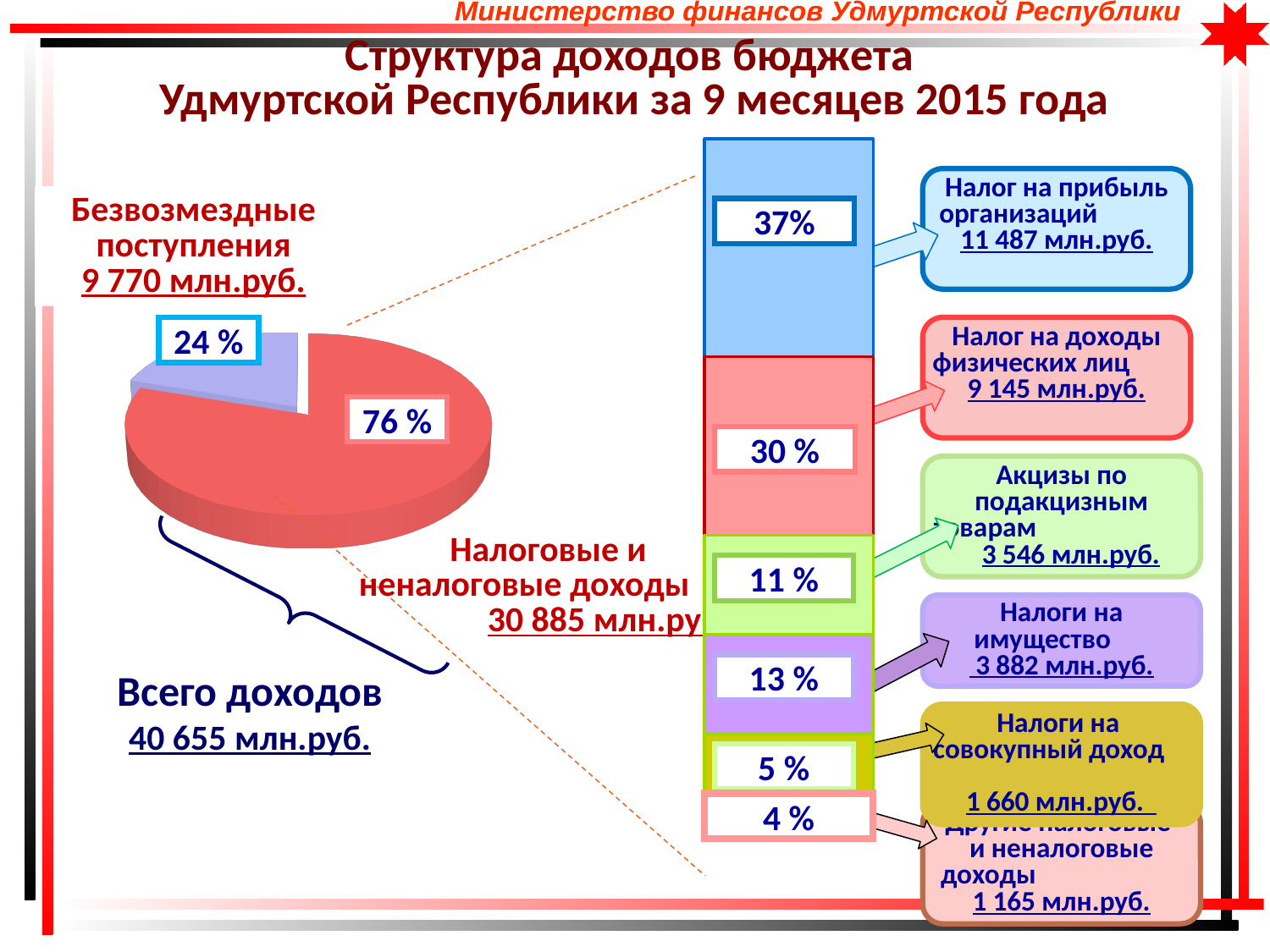
What total is shown for Всего доходов on the slide? 40 655 млн.руб. How many slices does the pie chart have? 2 In the stacked bar on the right, what is the difference in percentage points between Налог на прибыль организаций and Налог на доходы физических лиц? 7 What kind of chart is shown on the left side of the slide? pie chart In the pie chart, which slice is larger: Безвозмездные поступления or Налоговые и неналоговые доходы? Налоговые и неналоговые доходы In the pie chart, what is the value in млн.руб. for Безвозмездные поступления? 9 770 млн.руб. In the stacked bar on the right, what is the value in млн.руб. for Налог на доходы физических лиц? 9 145 млн.руб. In the pie chart, what share is shown for Безвозмездные поступления? 24 % In the stacked bar on the right, what percentage is shown for Налог на прибыль организаций? 37% How many segments does the stacked bar on the right have? 6 In the stacked bar on the right, which segment has the smallest percentage? Другие налоговые и неналоговые доходы In the pie chart, what share is shown for Налоговые и неналоговые доходы? 76 %